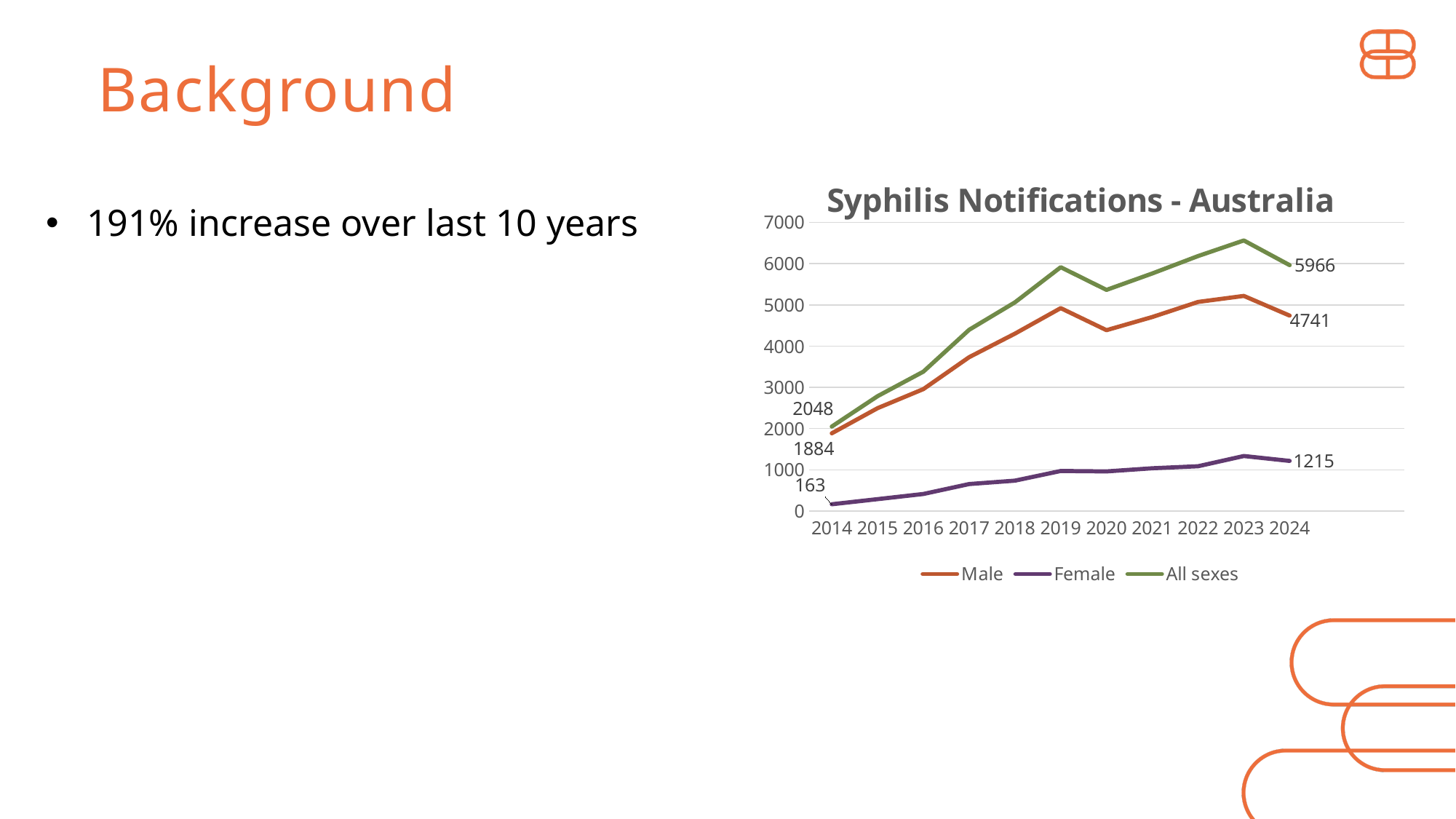
Which series has the lowest values across the chart? Female What is the title of the chart? Syphilis Notifications - Australia What kind of chart is shown on the slide? line chart What is the value for All sexes in 2014? 2048 What is the difference between the All sexes value in 2024 and in 2014? 3918 What is the value for All sexes in 2024? 5966 How many series does the legend list? 3 What is the difference between the Male and Female values in 2024? 3526 How many years are shown on the x axis? 11 What is the value for Male in 2024? 4741 What is the value for Female in 2014? 163 Is the value for All sexes in 2023 greater or less than 6000? greater